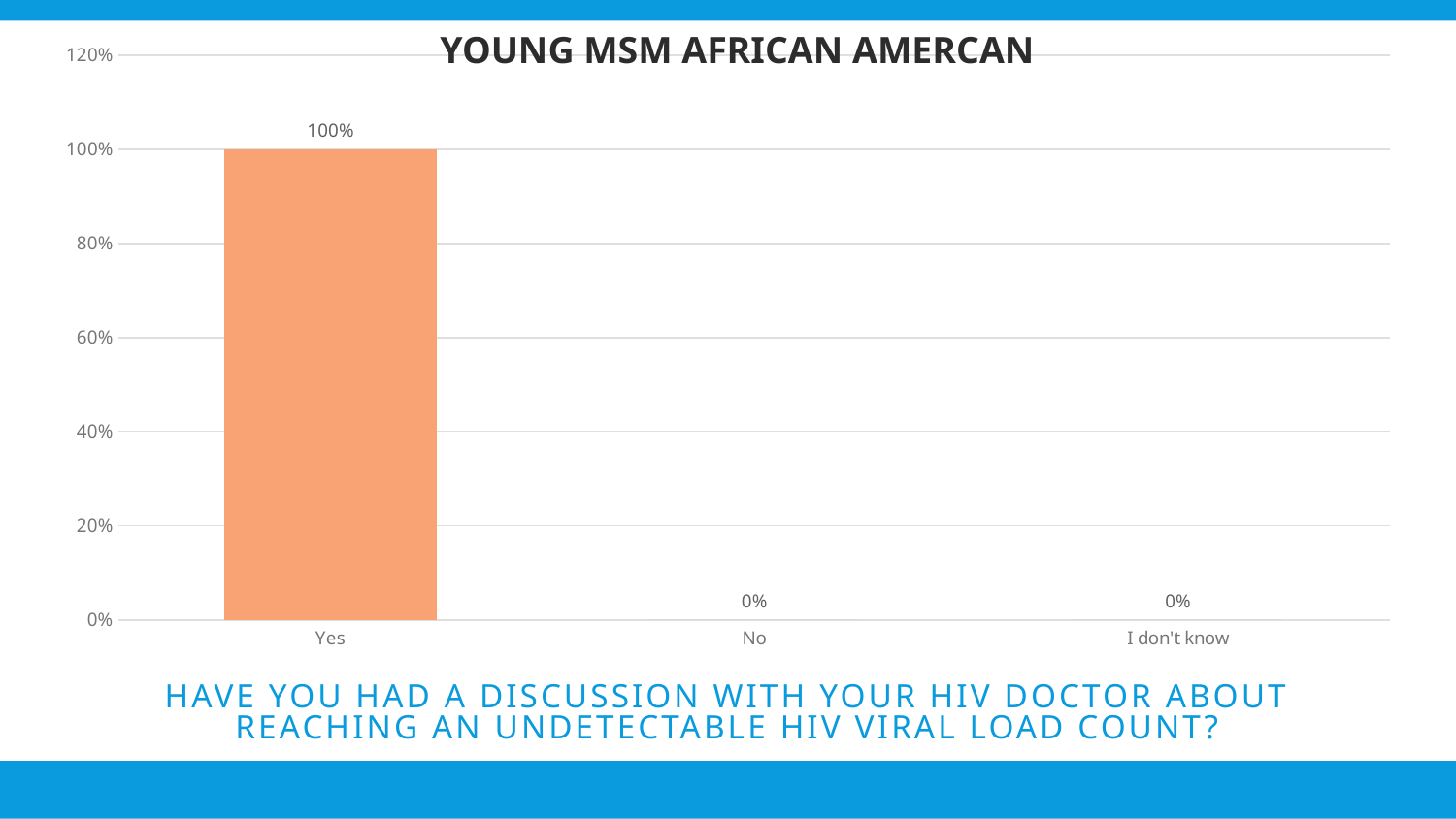
Which is larger, the value for Yes or the value for I don't know? Yes What is the value for No? 0% What is the title of the chart? YOUNG MSM AFRICAN AMERCAN What is the difference between the values for Yes and No? 100% What kind of chart is shown on the slide? bar chart What colour is the bar for Yes? orange How many categories are shown on the x axis? 3 What is the value for Yes? 100% Do the values rise or fall from Yes to No? fall Is the value for Yes greater or less than 80%? greater Which category has the highest value? Yes What is the value for I don't know? 0%